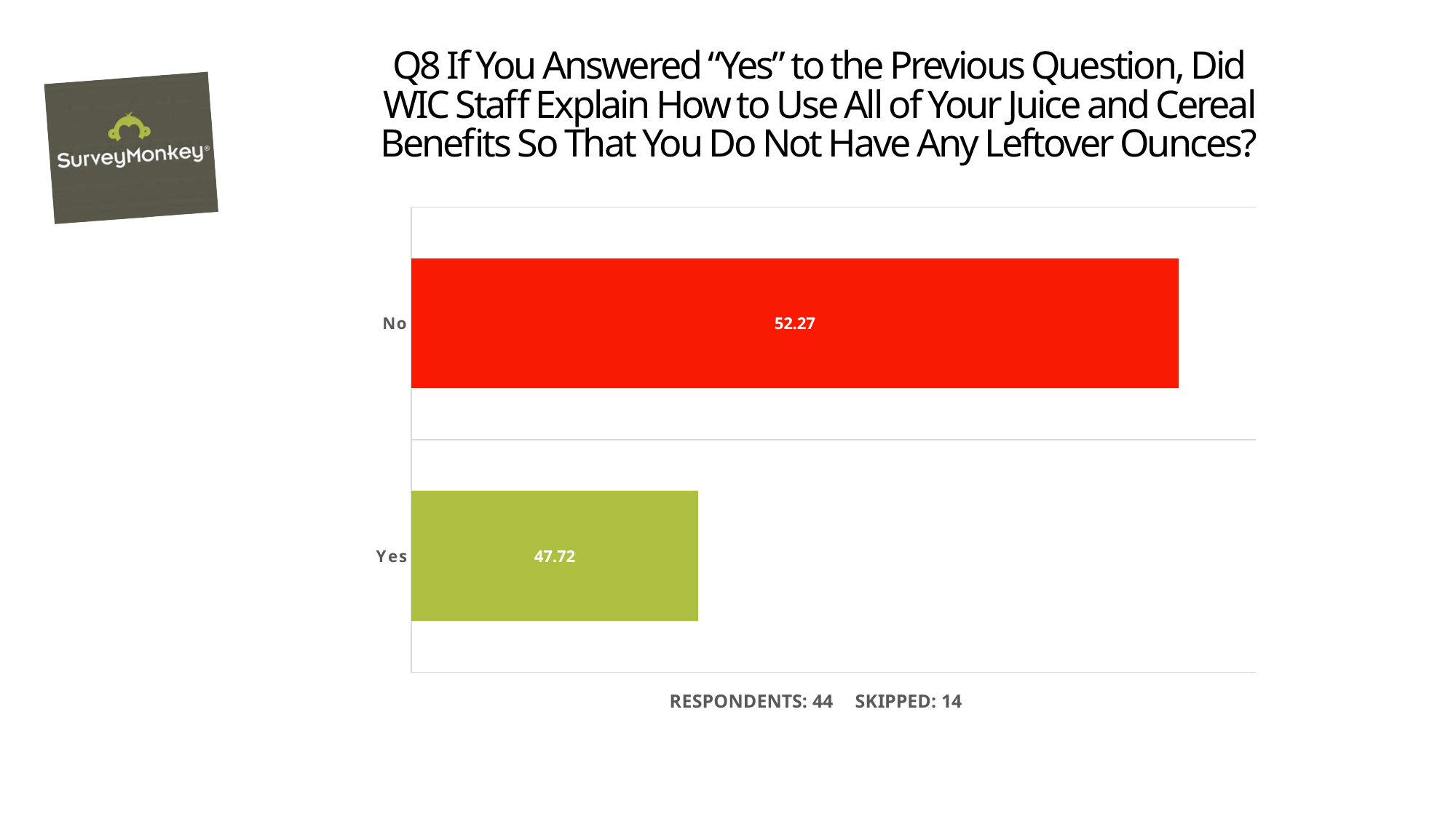
Which is larger, the value for "No" or the value for "Yes"? No Which category has the lowest value? Yes How many categories are shown in the chart? 2 How many respondents are reported below the chart? 44 What kind of chart is shown on the slide? Bar chart What is the value for the "No" category? 52.27 Which category has the highest value? No What colour is the bar for the "No" category? Red What is the value for the "Yes" category? 47.72 What is the difference between the values for "No" and "Yes"? 4.55